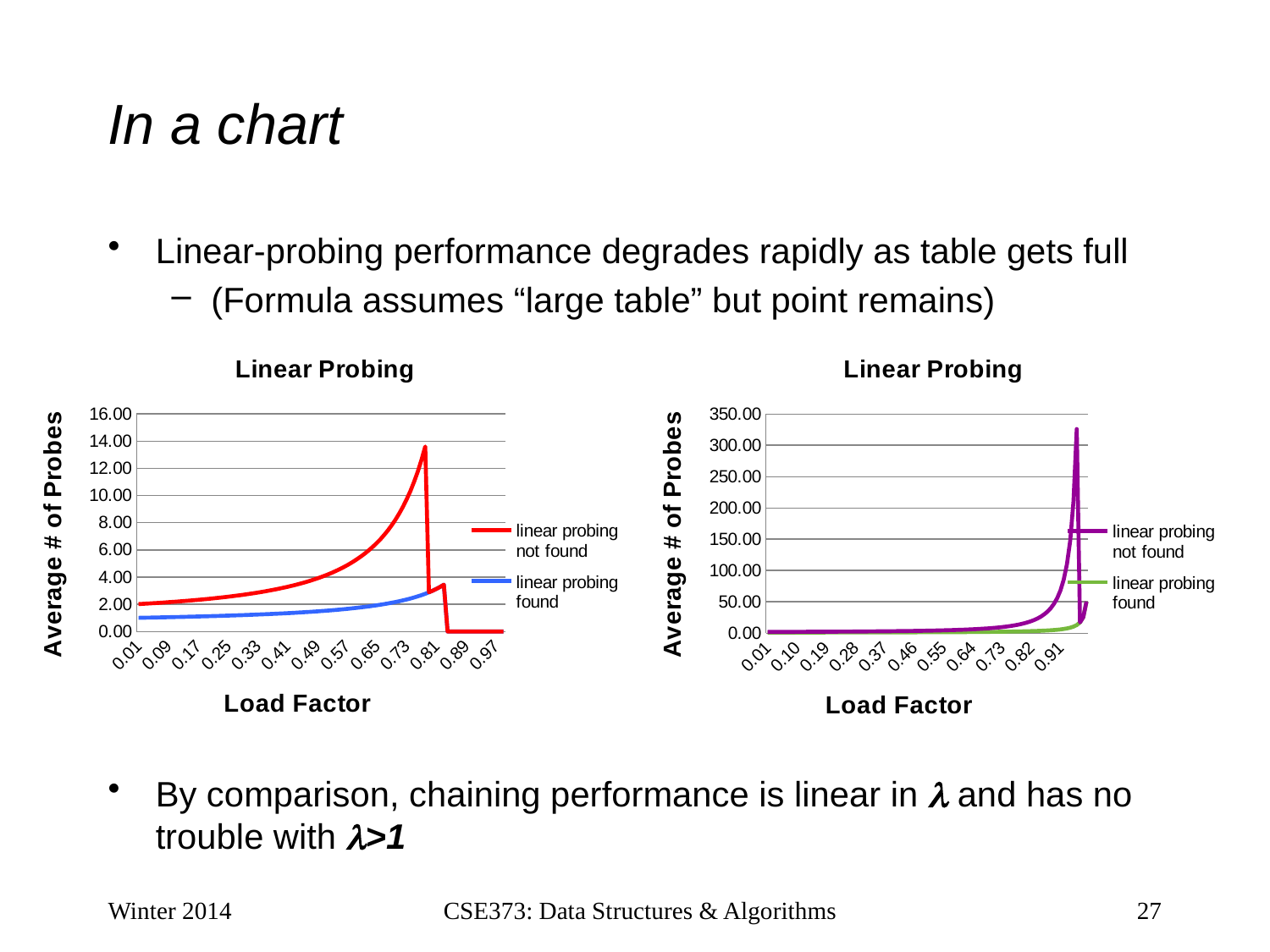
How many series does the legend of the right "Linear Probing" chart list? 2 In the left "Linear Probing" chart, is the value for linear probing not found at a load factor of 0.57 greater or less than 2.00? greater In the right "Linear Probing" chart, which series reaches the highest value? linear probing not found In the right "Linear Probing" chart, is the value for linear probing found at a load factor of 0.91 greater or less than 50.00? less In the right "Linear Probing" chart, is the peak value of linear probing not found greater or less than 300.00? greater In the left "Linear Probing" chart, does the linear probing found line rise or fall as the load factor increases from 0.01 to 0.73? rise In the right "Linear Probing" chart, what colour is the linear probing found line? green What kind of chart is the left chart titled "Linear Probing"? line chart How many series does the legend of the left "Linear Probing" chart list? 2 In the left "Linear Probing" chart, which series reaches the highest value? linear probing not found What is the title of the y axis on the left chart? Average # of Probes In the left "Linear Probing" chart, at a load factor of 0.73, which series has the larger value: linear probing not found or linear probing found? linear probing not found